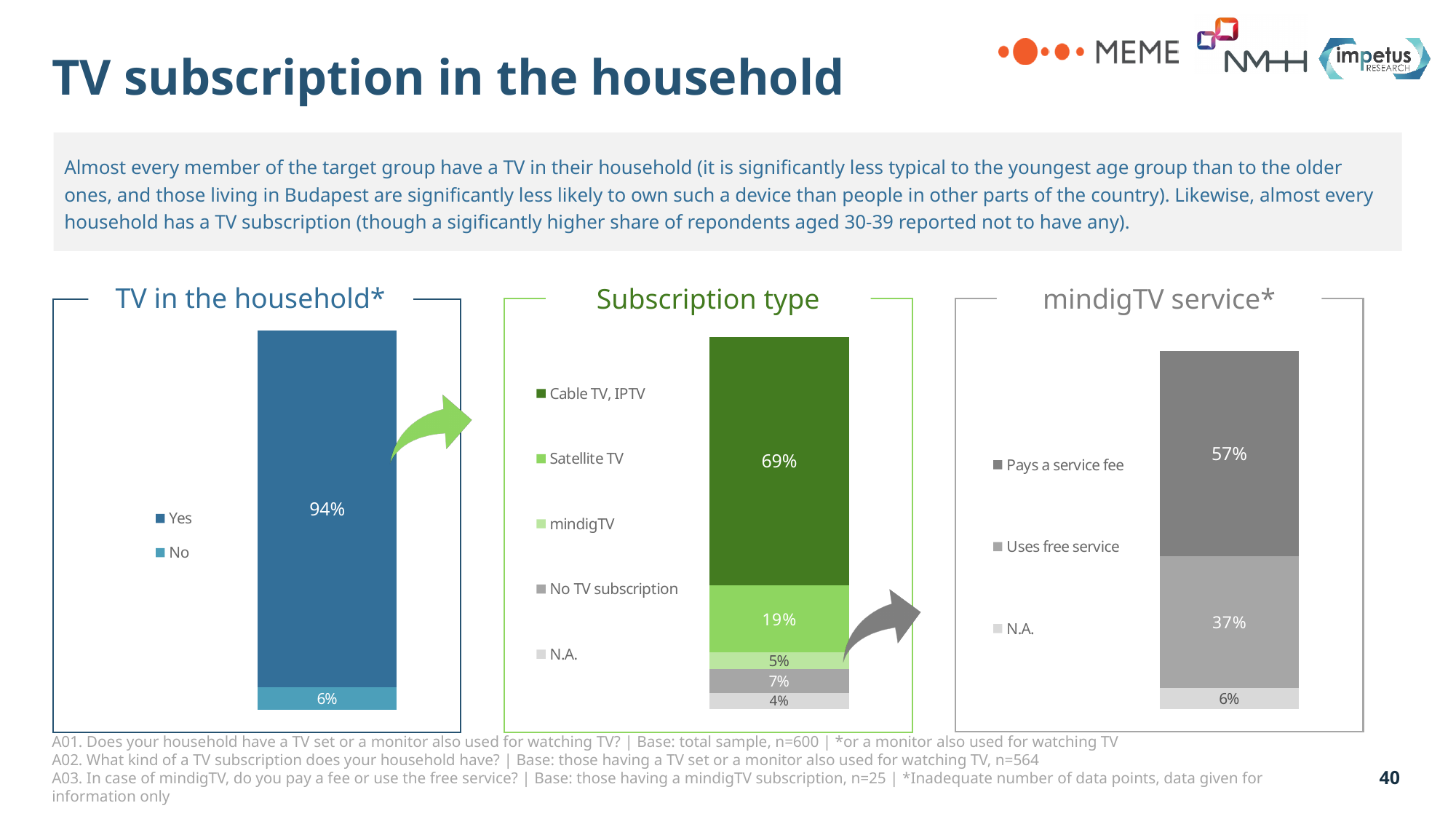
What type of chart is the "Subscription type" chart? Stacked bar chart In the "mindigTV service*" chart, what is the difference between Pays a service fee and Uses free service? 20% In the "Subscription type" chart, what is the value for No TV subscription? 7% In the "Subscription type" chart, which is larger: mindigTV or No TV subscription? No TV subscription In the "mindigTV service*" chart, what is the value for Uses free service? 37% In the "Subscription type" chart, what is the value for Satellite TV? 19% How many categories does the legend of the "Subscription type" chart list? 5 In the "TV in the household*" chart, what is the difference between the Yes and No shares? 88% In the "mindigTV service*" chart, which category has the highest value? Pays a service fee In the "Subscription type" chart, which category has the lowest value? N.A. In the "Subscription type" chart, what is the value for Cable TV, IPTV? 69% In the "TV in the household*" chart, what percentage of respondents answered Yes? 94%